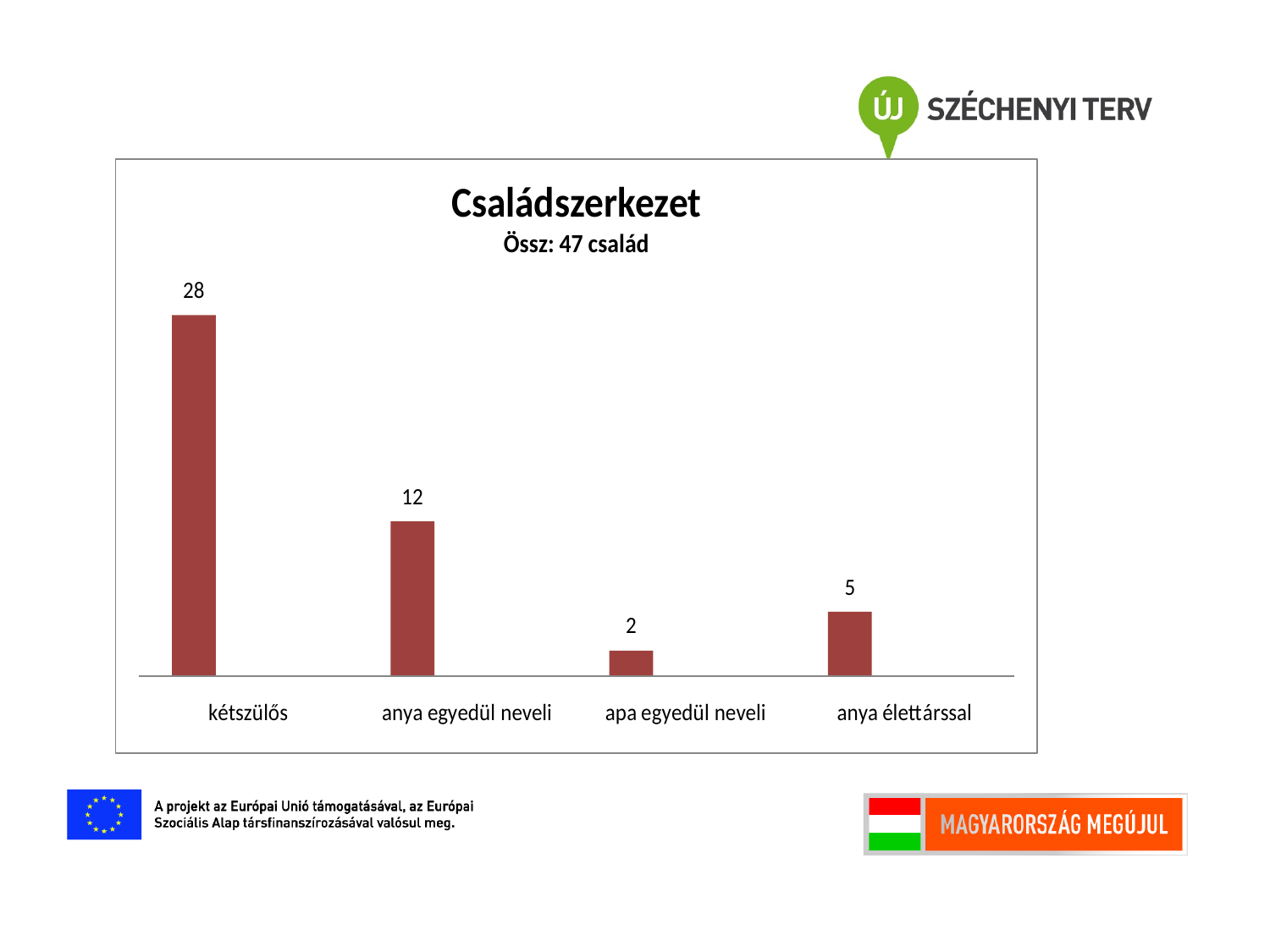
What kind of chart is shown on the slide? bar chart What is the value for anya egyedül neveli? 12 What is the title of the chart? Családszerkezet What is the difference between the values for kétszülős and anya egyedül neveli? 16 What total number of families does the chart subtitle state? 47 Which is larger, the value for anya élettárssal or the value for apa egyedül neveli? anya élettárssal Which category has the lowest value? apa egyedül neveli What is the value for kétszülős? 28 What is the value for apa egyedül neveli? 2 How many categories are shown in the chart? 4 What is the value for anya élettárssal? 5 Which category has the highest value? kétszülős